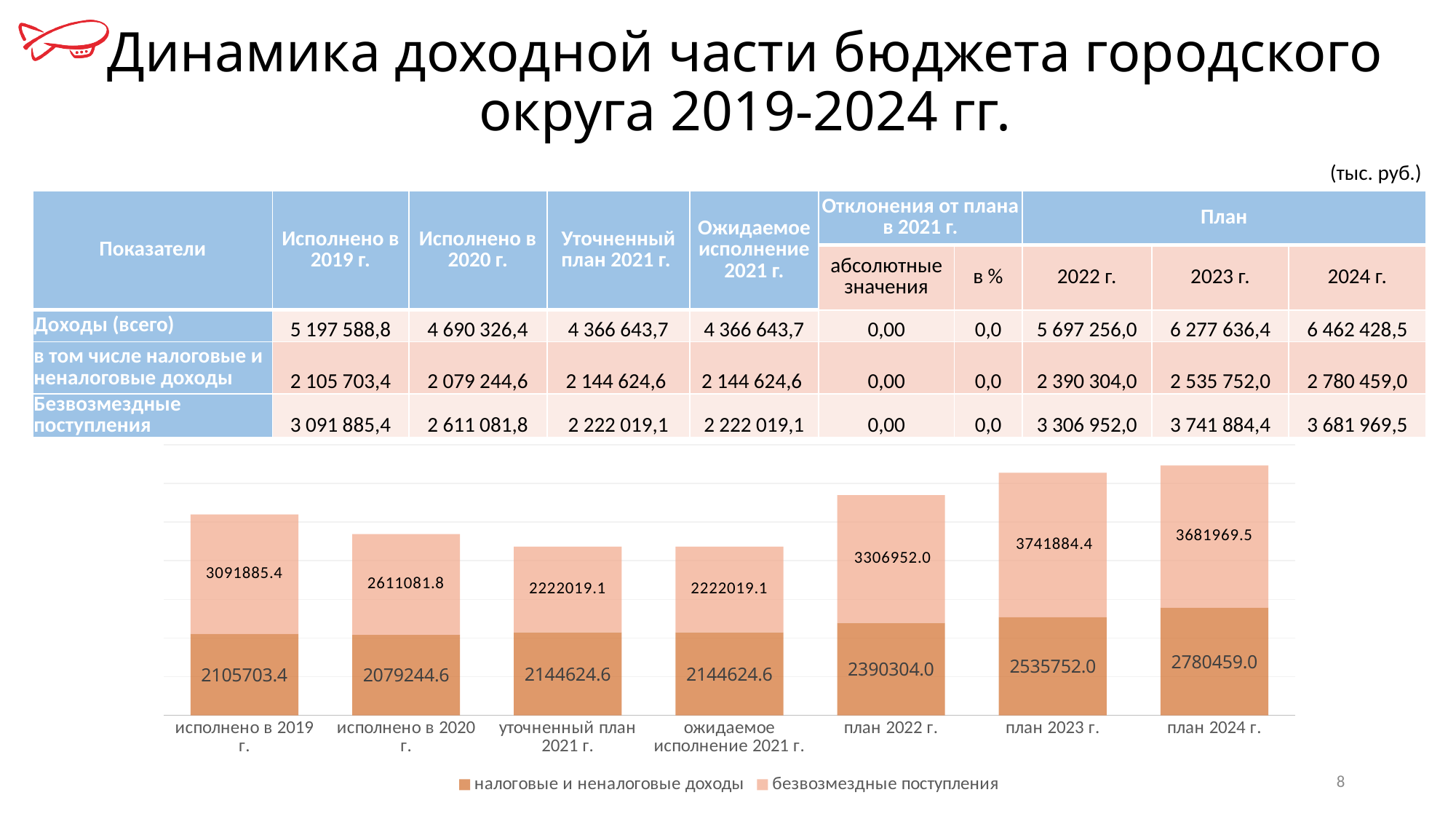
Which is larger: безвозмездные поступления for исполнено в 2019 г. or for план 2022 г.? план 2022 г. Which category has the highest value for налоговые и неналоговые доходы? план 2024 г. What is the value of безвозмездные поступления for план 2022 г.? 3306952.0 Which category has the lowest value for налоговые и неналоговые доходы? исполнено в 2020 г. What is the difference between налоговые и неналоговые доходы for план 2024 г. and for исполнено в 2019 г.? 674755.6 Which category has the highest value for безвозмездные поступления? план 2023 г. What is the value of безвозмездные поступления for исполнено в 2020 г.? 2611081.8 How many categories are shown on the x axis of the chart? 7 How many series does the chart legend list? 2 What is the value of налоговые и неналоговые доходы for план 2024 г.? 2780459.0 What type of chart is shown on the slide? stacked bar chart What is the total of the stacked bar for исполнено в 2019 г.? 5197588.8